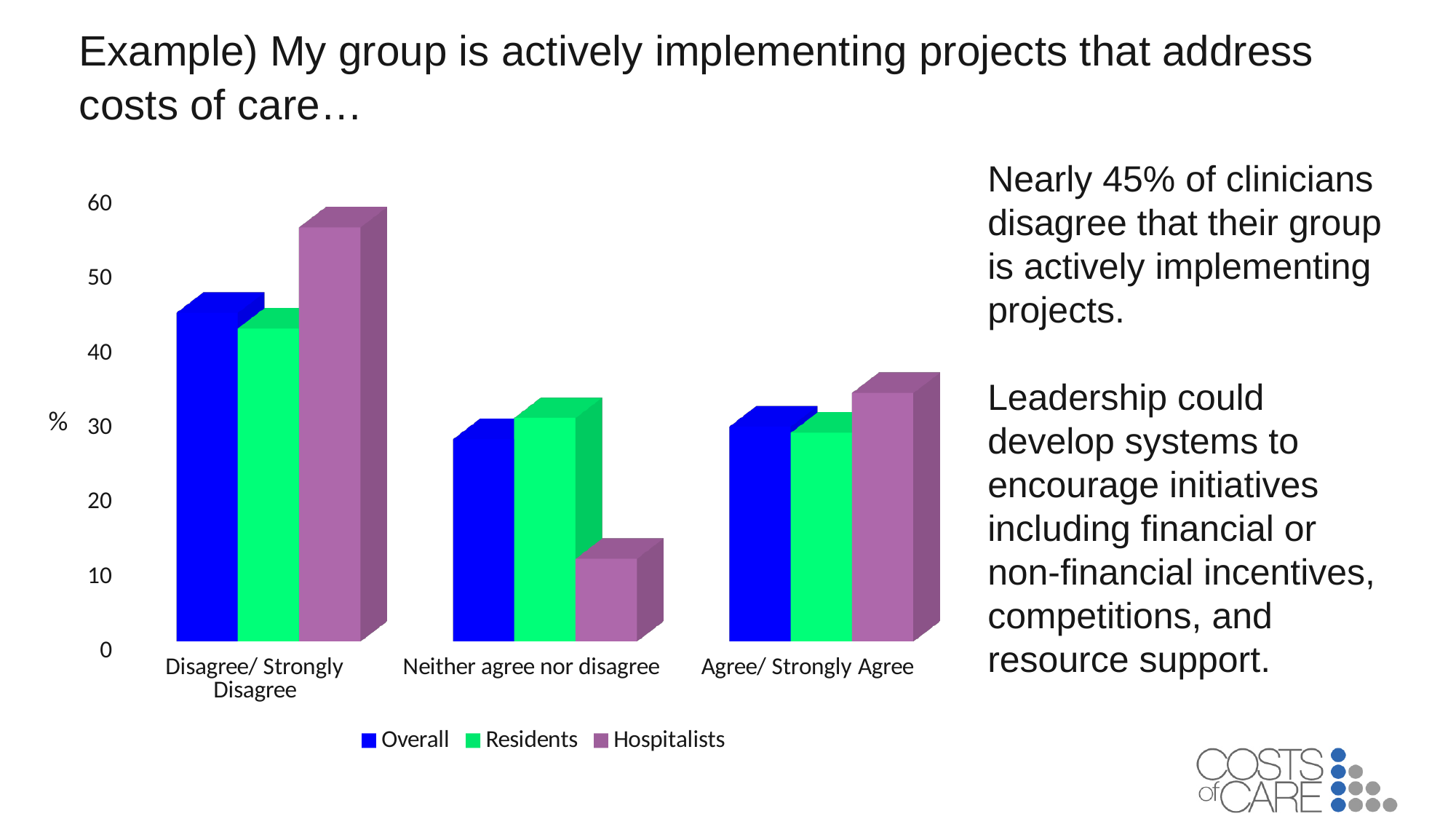
Which series are listed in the chart's legend? Overall, Residents, Hospitalists Does the Overall series rise or fall from Disagree/ Strongly Disagree to Neither agree nor disagree? fall What label is shown on the y axis of the chart? % What kind of chart is shown on the slide? bar chart How many series does the chart's legend list? 3 In the Disagree/ Strongly Disagree category, which series has the highest value? Hospitalists Is the Hospitalists value for Disagree/ Strongly Disagree greater or less than 50? greater Is the Hospitalists value for Neither agree nor disagree greater or less than 20? less Which is larger: the Residents value or the Hospitalists value for Neither agree nor disagree? Residents In the Neither agree nor disagree category, which series has the lowest value? Hospitalists How many response categories are shown on the x axis of the chart? 3 For the Hospitalists series, which category has the lowest value? Neither agree nor disagree